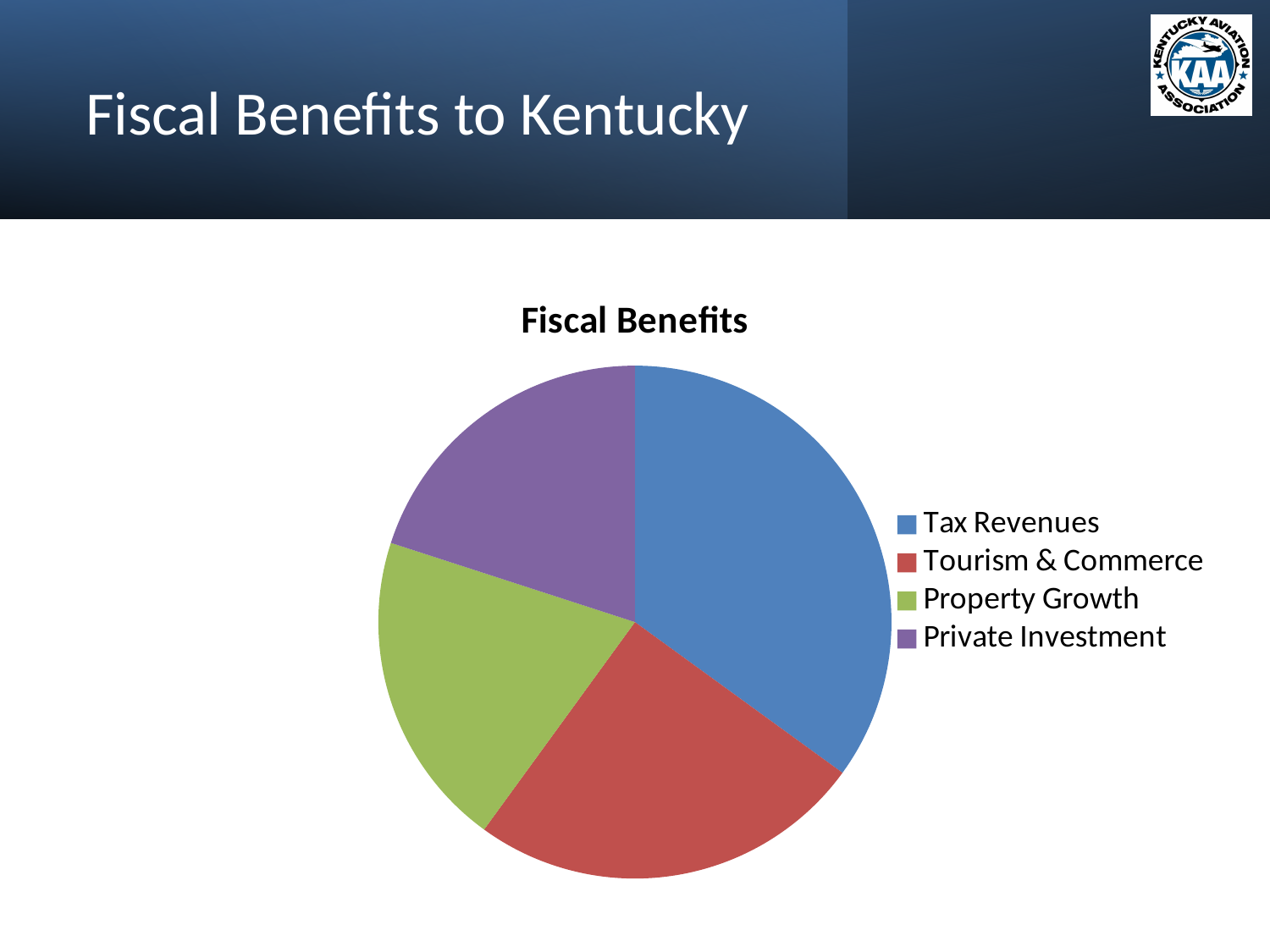
Which slice is larger, Tourism & Commerce or Private Investment? Tourism & Commerce Which slice is larger, Tax Revenues or Tourism & Commerce? Tax Revenues How many slices does the pie chart have? 4 How many entries does the legend list? 4 What colour is the Property Growth slice? green Which slice is larger, Private Investment or Tax Revenues? Tax Revenues What kind of chart is shown on the slide? pie chart What is the title of the chart? Fiscal Benefits Which category has the largest slice of the pie? Tax Revenues